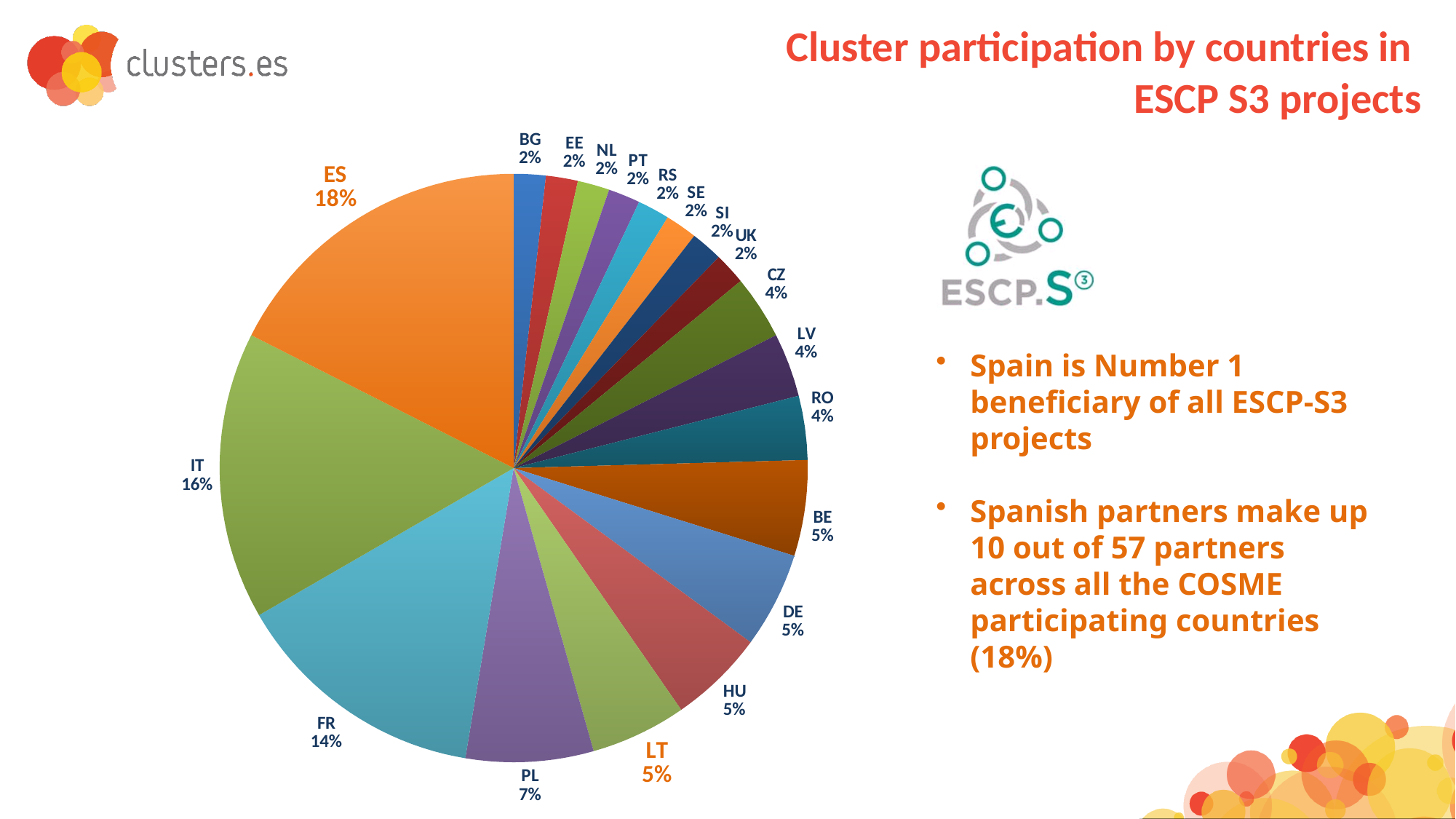
What is the difference in percentage points between ES and IT? 2 How many countries (slices) are shown in the pie chart? 19 What share of the pie does IT have? 16% Which has a larger share, IT or FR? IT What is the difference in percentage points between FR and PL? 7 What is the title of the chart on the slide? Cluster participation by countries in ESCP S3 projects What share of the pie does ES have? 18% Which country has the largest slice of the pie? ES What share of the pie does CZ have? 4% What share of the pie does PL have? 7% What share of the pie does FR have? 14% What kind of chart is shown on the slide? Pie chart